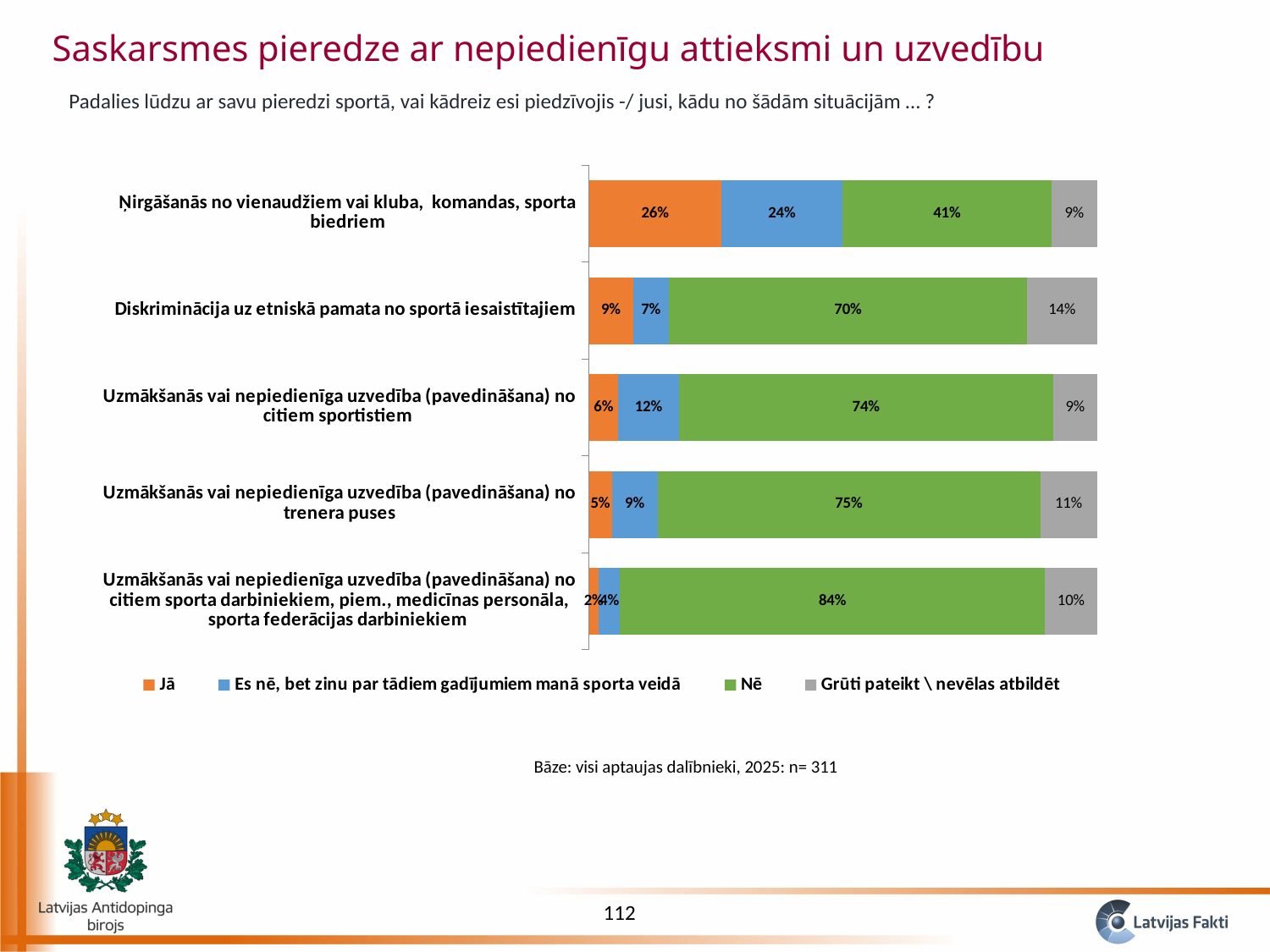
What is the "Es nē, bet zinu par tādiem gadījumiem manā sporta veidā" value for "Uzmākšanās vai nepiedienīga uzvedība (pavedināšana) no citiem sportistiem"? 12% What percentage answered "Jā" for "Ņirgāšanās no vienaudžiem vai kluba, komandas, sporta biedriem"? 26% Which colour represents the "Nē" series in the chart? Green How many categories (situations) are shown in the chart? 5 What is the difference between the "Nē" values for "Uzmākšanās vai nepiedienīga uzvedība (pavedināšana) no trenera puses" and "Ņirgāšanās no vienaudžiem vai kluba, komandas, sporta biedriem"? 34 percentage points How many series does the legend list? 4 Which category has the lowest "Jā" share? Uzmākšanās vai nepiedienīga uzvedība (pavedināšana) no citiem sporta darbiniekiem, piem., medicīnas personāla, sporta federācijas darbiniekiem What is the "Grūti pateikt \ nevēlas atbildēt" value for "Uzmākšanās vai nepiedienīga uzvedība (pavedināšana) no trenera puses"? 11% What kind of chart is shown on the slide? Stacked horizontal bar chart Which is larger: the "Jā" value for "Diskriminācija uz etniskā pamata no sportā iesaistītajiem" or the "Jā" value for "Uzmākšanās vai nepiedienīga uzvedība (pavedināšana) no citiem sportistiem"? Diskriminācija uz etniskā pamata no sportā iesaistītajiem What percentage answered "Nē" for "Diskriminācija uz etniskā pamata no sportā iesaistītajiem"? 70% Which category has the highest "Nē" share? Uzmākšanās vai nepiedienīga uzvedība (pavedināšana) no citiem sporta darbiniekiem, piem., medicīnas personāla, sporta federācijas darbiniekiem